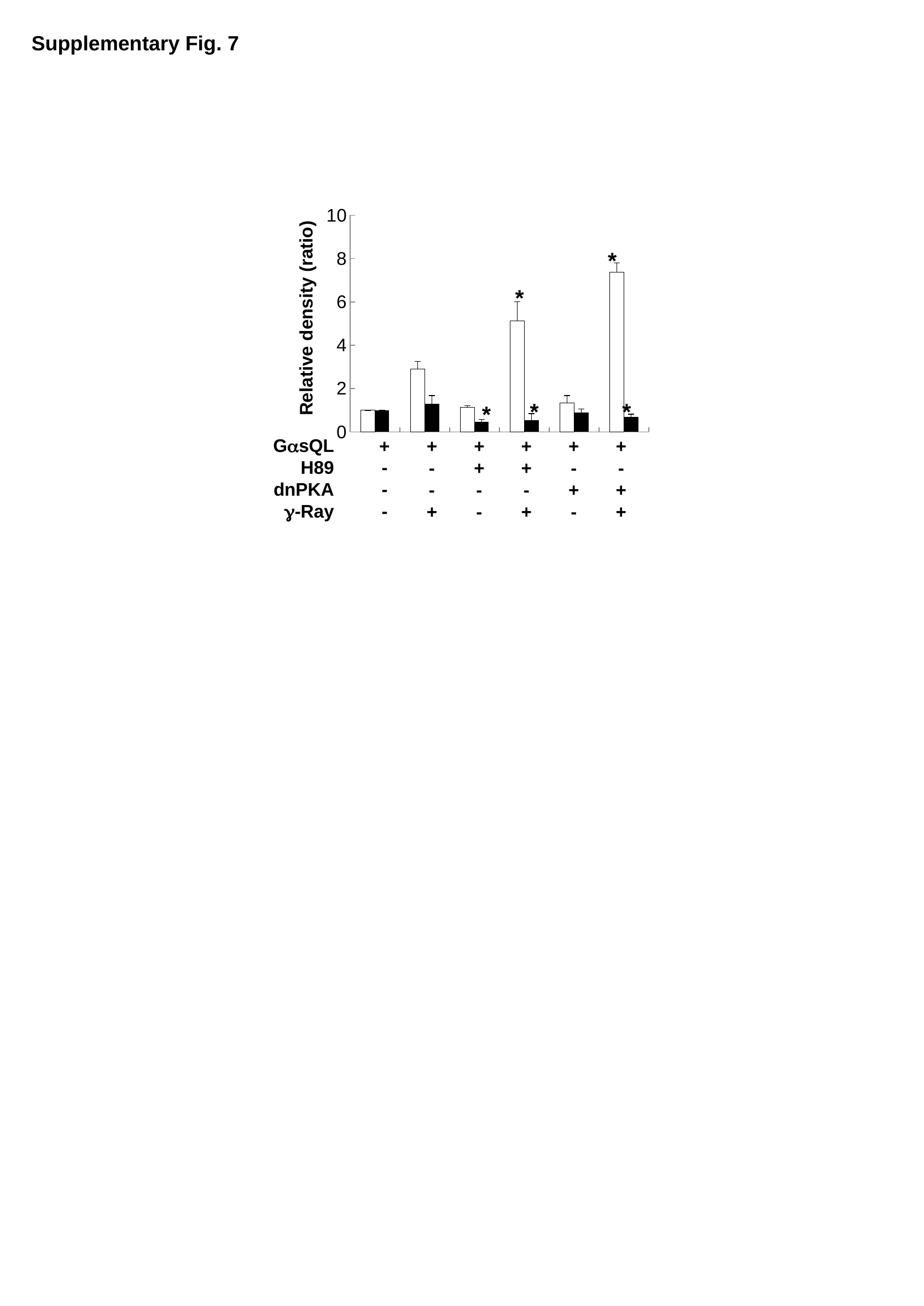
How many groups of bars (treatment conditions) are plotted along the x axis? 6 Is the black bar in the sixth group (dnPKA +, γ-Ray +) greater or less than 2? less Which group has the tallest white bar? the sixth group (dnPKA +, γ-Ray +) Is the white bar in the fourth group (H89 +, γ-Ray +) greater or less than 4? greater In the sixth group (dnPKA +, γ-Ray +), which is larger, the white bar or the black bar? the white bar Is the white bar in the sixth group (dnPKA +, γ-Ray +) greater or less than 6? greater What is the highest value shown on the y axis? 10 What kind of chart is shown on the slide? bar chart What is the label of the y axis? Relative density (ratio) Which is larger, the white bar in the fourth group (H89 +, γ-Ray +) or the white bar in the second group (γ-Ray + only)? the white bar in the fourth group How many bars are plotted in total on the chart? 12